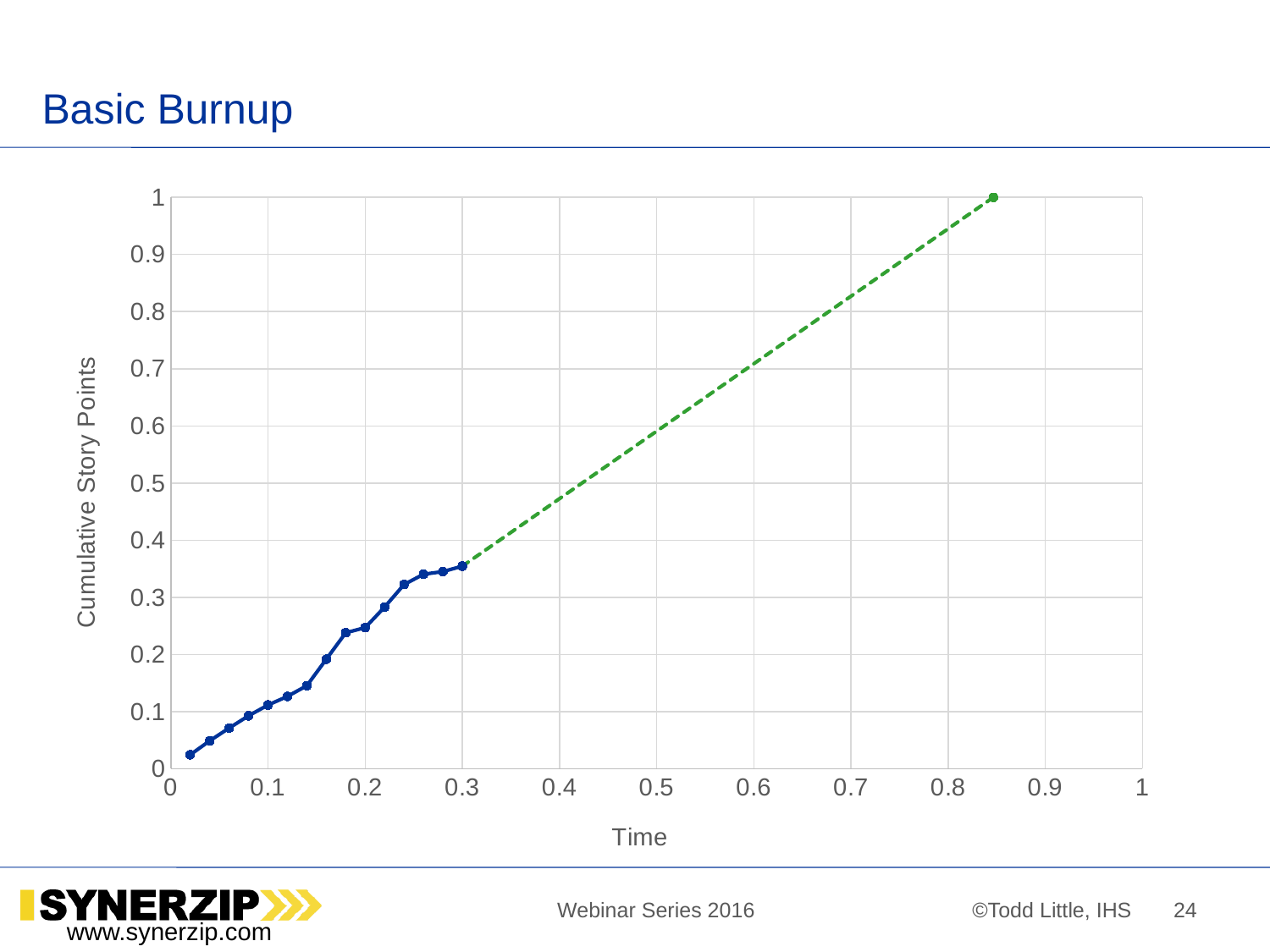
Is the cumulative story points value of the blue line at time 0.1 greater or less than 0.2? less Is the cumulative story points value of the blue line at time 0.3 greater or less than 0.4? less Do the cumulative story points rise or fall as time increases along the x axis? rise Which is larger: the cumulative story points at time 0.3 or at time 0.1? time 0.3 What kind of chart is shown on the slide? line chart What is the title of the chart on the slide? Basic Burnup Is the cumulative story points value of the blue line at time 0.2 greater or less than 0.2? greater What is the highest value shown on the x axis? 1 How many data points are plotted on the blue solid line? 15 What cumulative story points value does the green dashed projection line reach at its end point? 1 What is the label of the y axis? Cumulative Story Points